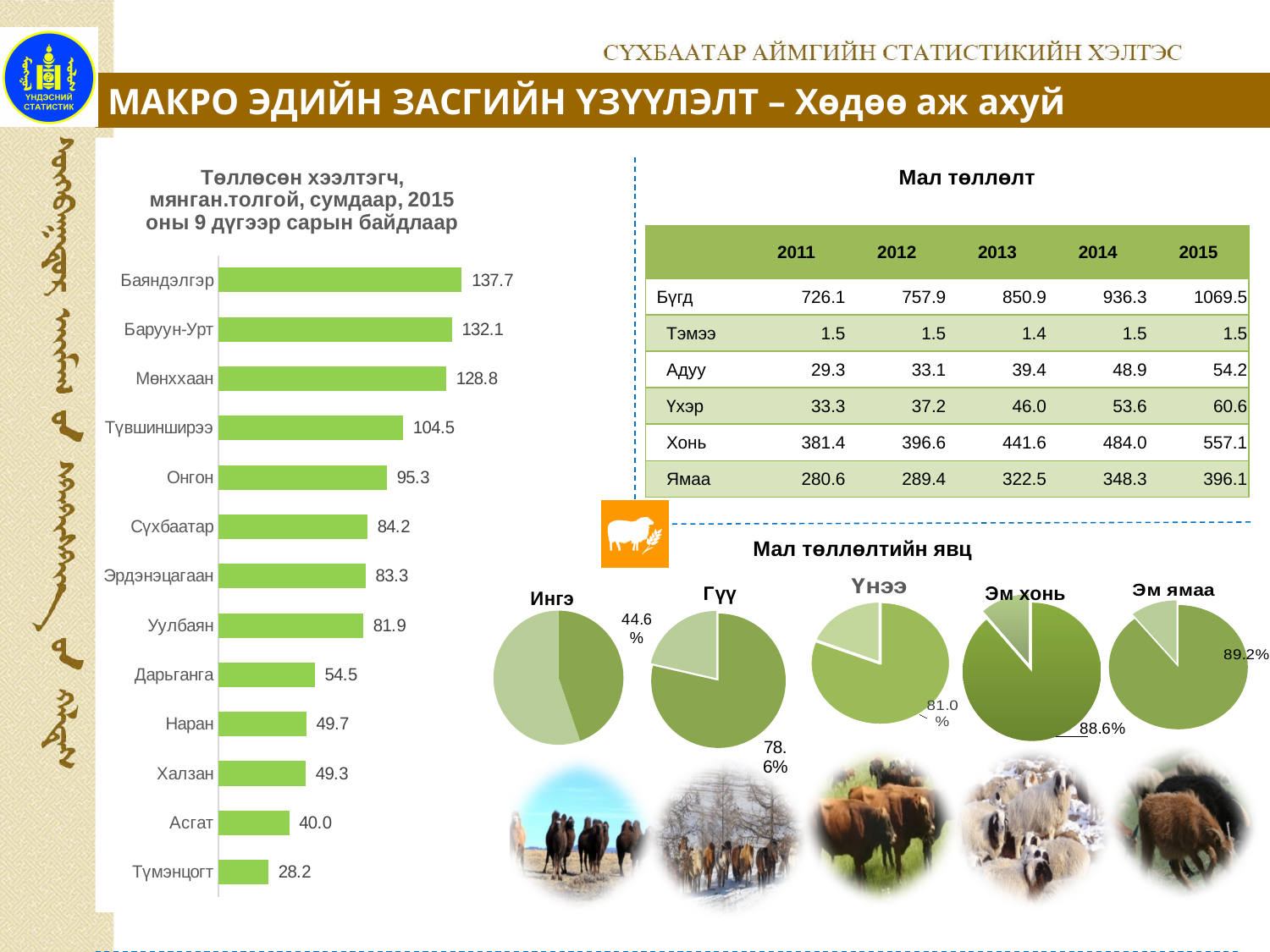
In the 'Мал төллөлтийн явц' pie charts, what share is labelled on the Эм ямаа pie? 89.2% In the bar chart on the left, what is the value for Онгон? 95.3 In the bar chart on the left, which category has the lowest value? Түмэнцогт What kind of chart is the chart on the left of the slide? Bar chart In the bar chart on the left, what is the difference between the values for Баяндэлгэр and Түмэнцогт? 109.5 In the bar chart on the left, what is the difference between the values for Баруун-Урт and Мөнххаан? 3.3 In the 'Мал төллөлтийн явц' pie charts, what share is labelled on the Ингэ pie? 44.6% In the bar chart 'Төллөсөн хээлтэгч, мянган.толгой, сумдаар, 2015 оны 9 дүгээр сарын байдлаар', what is the value for Баяндэлгэр? 137.7 In the bar chart on the left, which category has the highest value? Баяндэлгэр How many categories (sums) are shown in the bar chart on the left? 13 In the bar chart on the left, which is larger, the value for Дарьганга or the value for Наран? Дарьганга In the bar chart on the left, what is the value for Асгат? 40.0